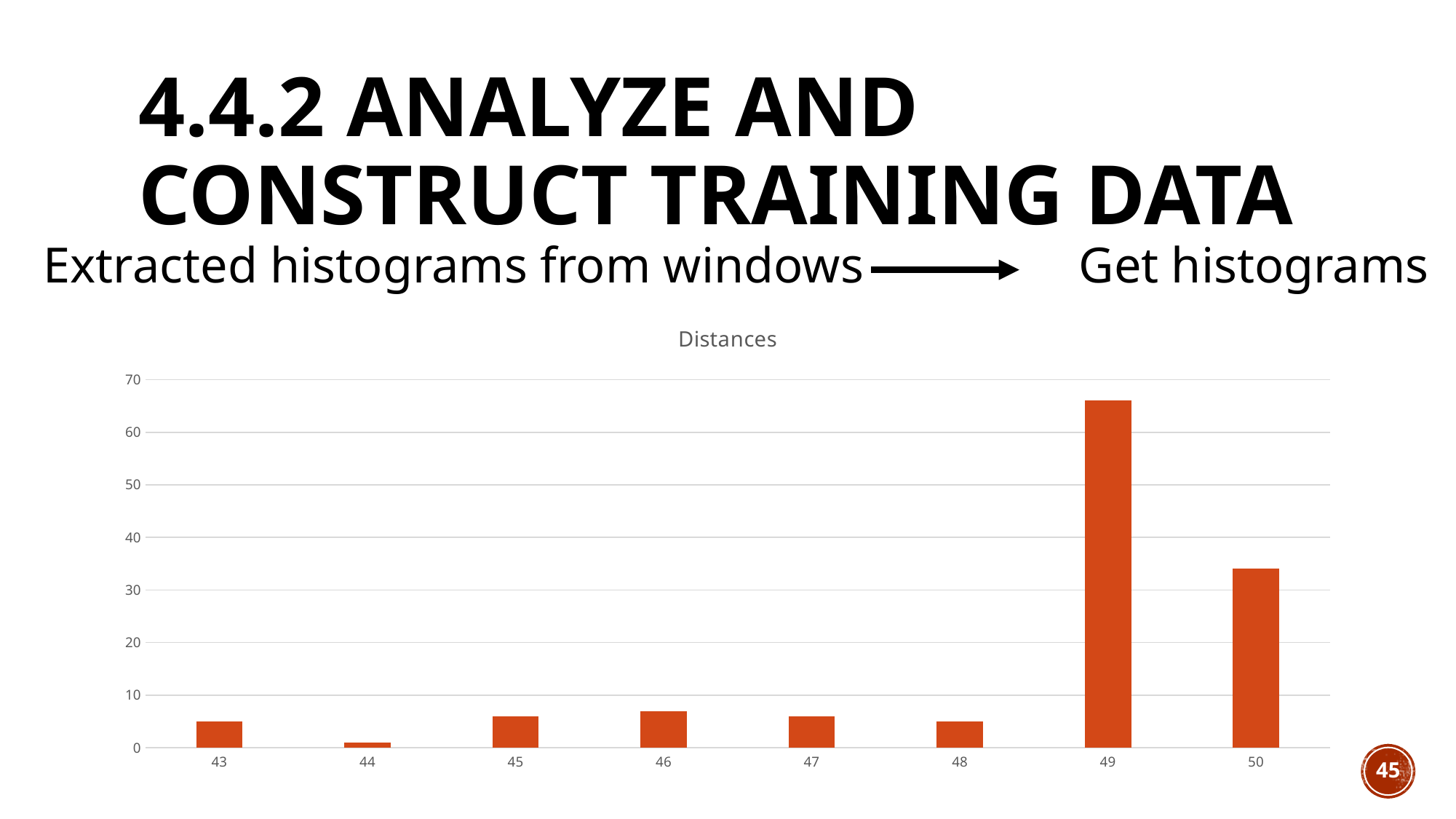
How many categories are shown on the x axis of the chart? 8 Is the value for category 49 greater or less than 60? greater What kind of chart is shown on the slide? bar chart Is the value for category 43 greater or less than 10? less Which has the larger value, category 46 or category 44? 46 Which category has the lowest bar in the chart? 44 Which has the larger value, category 49 or category 50? 49 Is the value for category 50 greater or less than 30? greater What is the title of the chart? Distances What is the highest value shown on the y axis of the chart? 70 Which category has the highest bar in the chart? 49